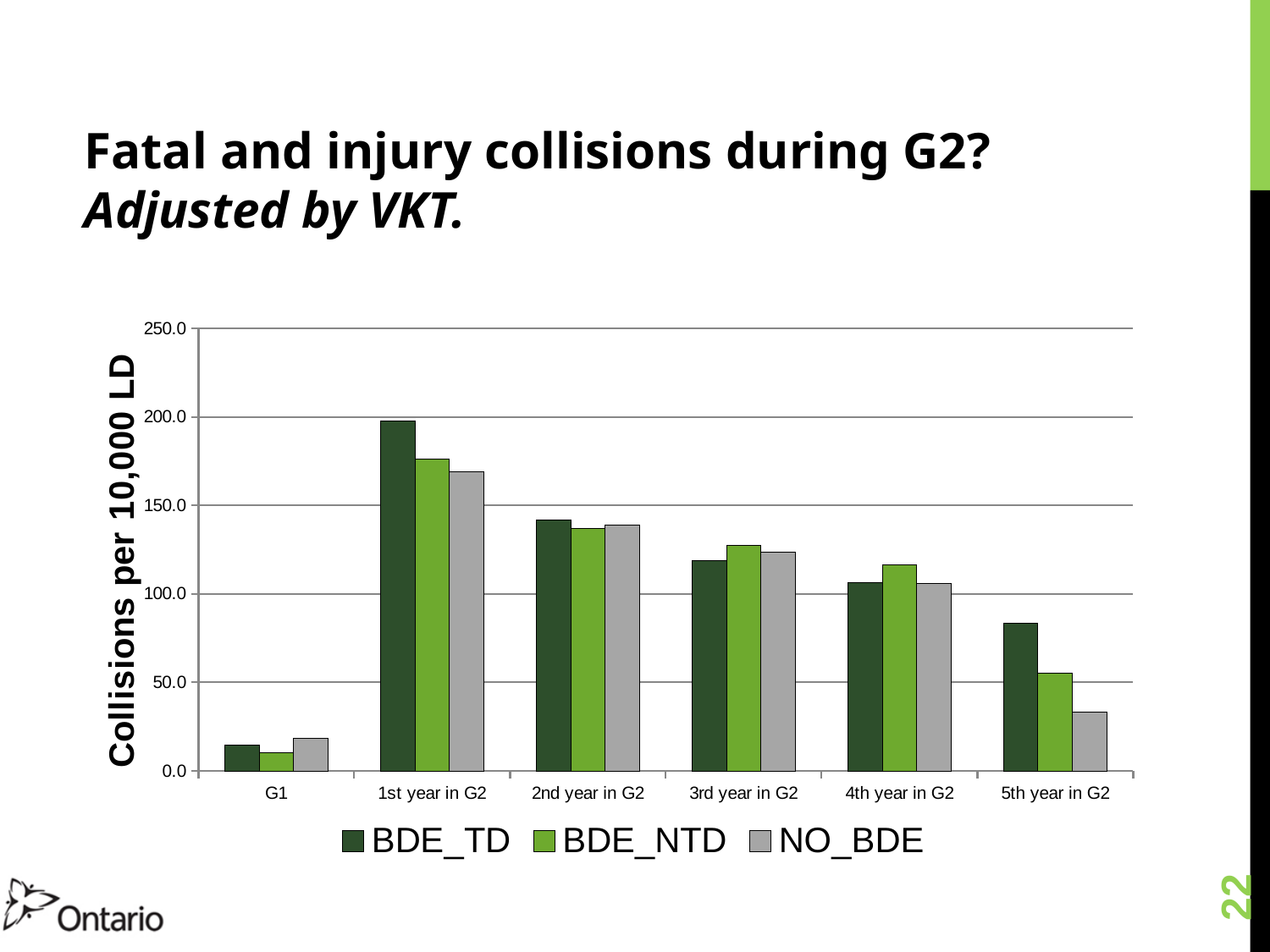
For which category is the BDE_TD value highest? 1st year in G2 Is the NO_BDE value for 5th year in G2 greater or less than 50? less How many categories are shown along the x axis? 6 From 1st year in G2 to 5th year in G2, do the BDE_TD values rise or fall? fall For 5th year in G2, which is larger: BDE_TD or NO_BDE? BDE_TD What is the title of the y axis? Collisions per 10,000 LD Is the BDE_NTD value for 4th year in G2 greater or less than 100? greater What kind of chart is shown on the slide? bar chart For which category is the BDE_NTD value lowest? G1 Is the BDE_TD value for 1st year in G2 greater or less than 150? greater How many series does the legend list? 3 What are the three series named in the legend? BDE_TD, BDE_NTD, NO_BDE